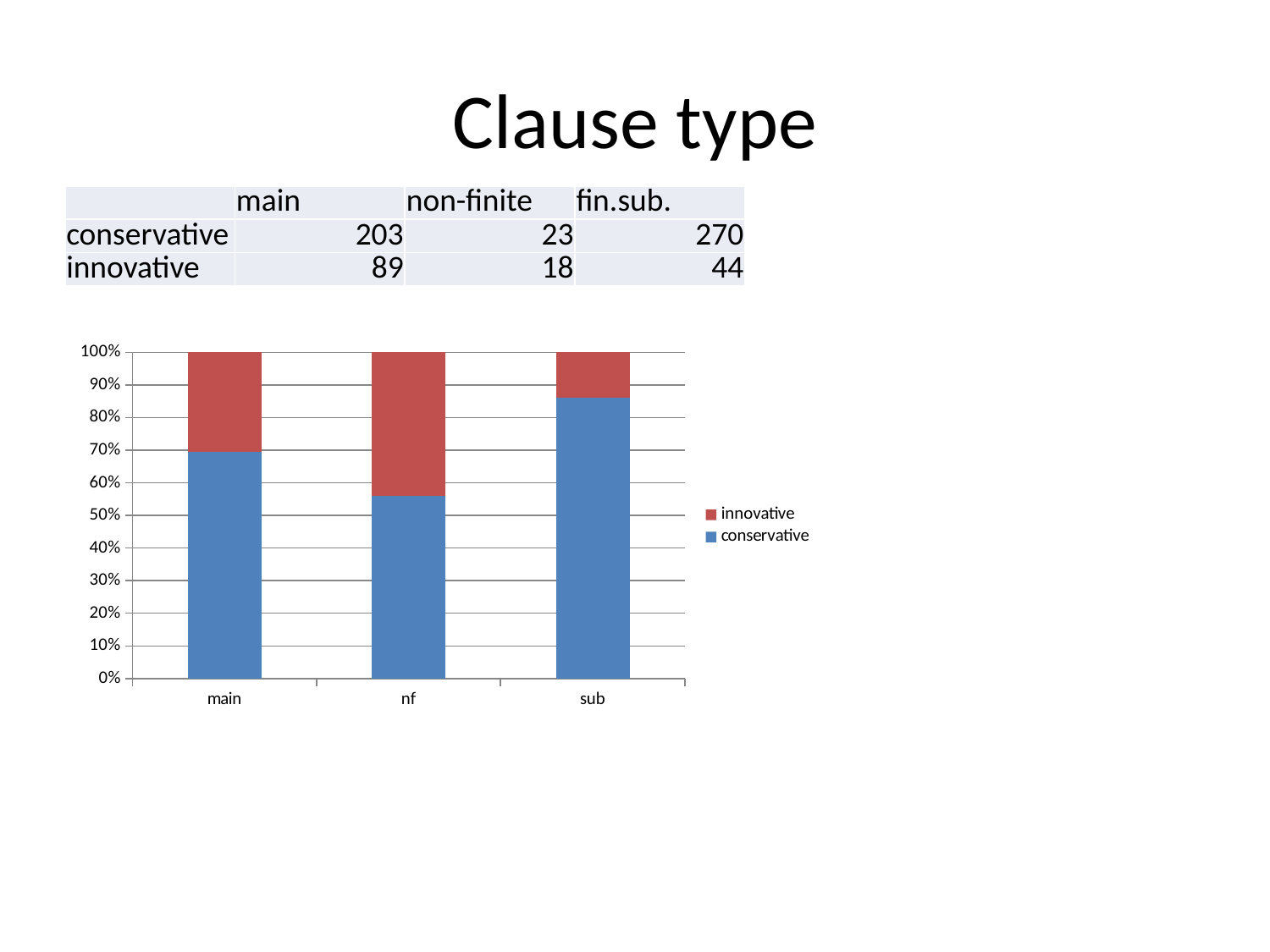
Is the innovative share for nf greater or less than 30%? greater Is the conservative share for main greater or less than 60%? greater Which category has the largest innovative share in the chart? nf Which colour represents the innovative series in the chart? red How many series does the chart legend list? 2 Which category has the smallest conservative share in the chart? nf Is the conservative share for sub greater or less than 80%? greater How many categories are shown on the x axis of the chart? 3 Which has the larger conservative share in the chart, main or nf? main Which category has the largest conservative share in the chart? sub What kind of chart is shown on the slide? stacked bar chart